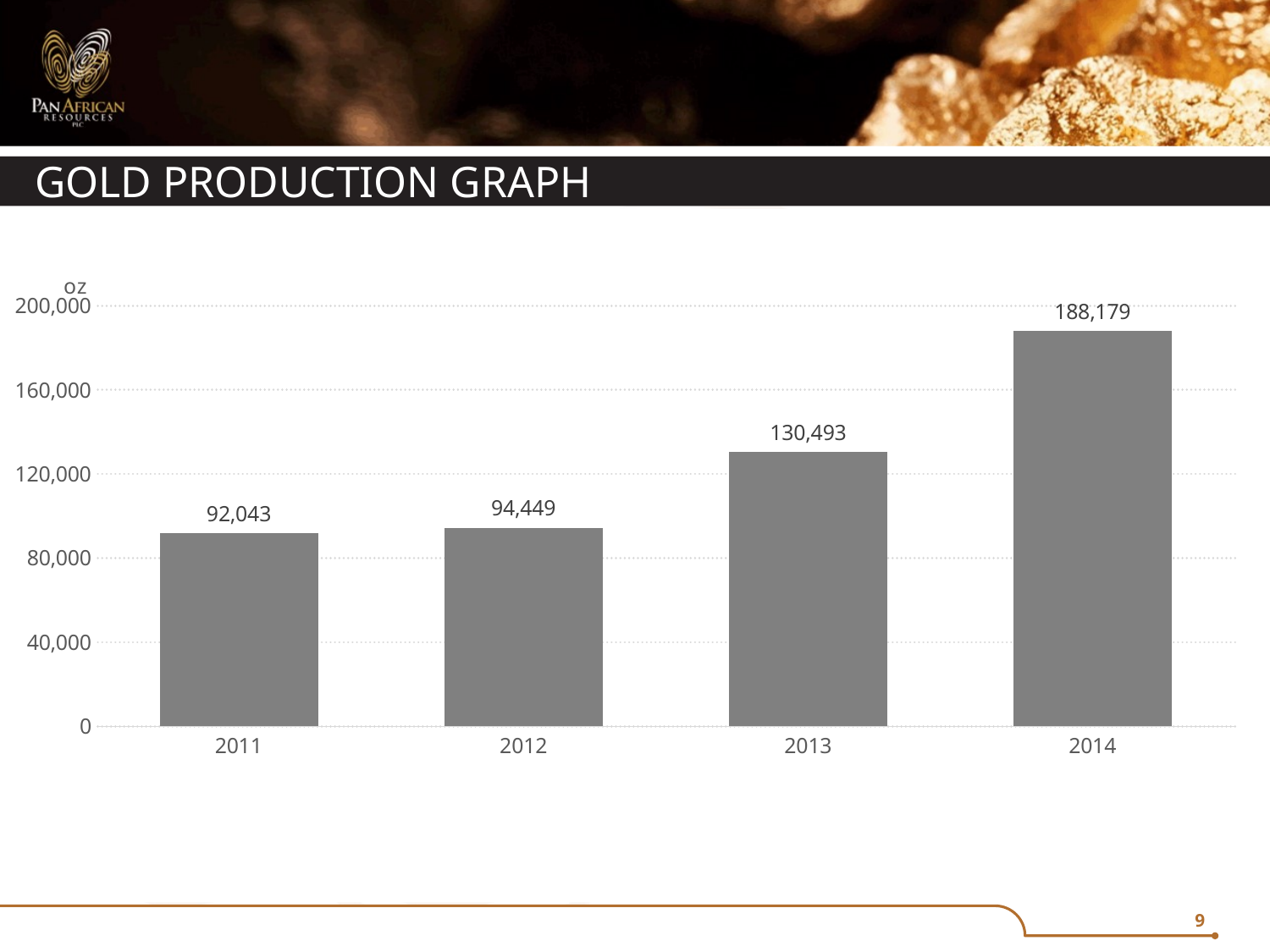
Which year had the highest gold production? 2014 How many years are shown on the chart? 4 What is the difference in gold production between 2012 and 2011? 2,406 Is the gold production for 2013 greater or less than 120,000? greater What was the gold production in 2011? 92,043 What was the gold production in 2013? 130,493 What is the difference in gold production between 2014 and 2013? 57,686 Which year had higher gold production, 2012 or 2013? 2013 Which year had the lowest gold production? 2011 Does gold production rise or fall from 2011 to 2014? Rise What kind of chart is shown on the slide? Bar chart What was the gold production in 2014? 188,179